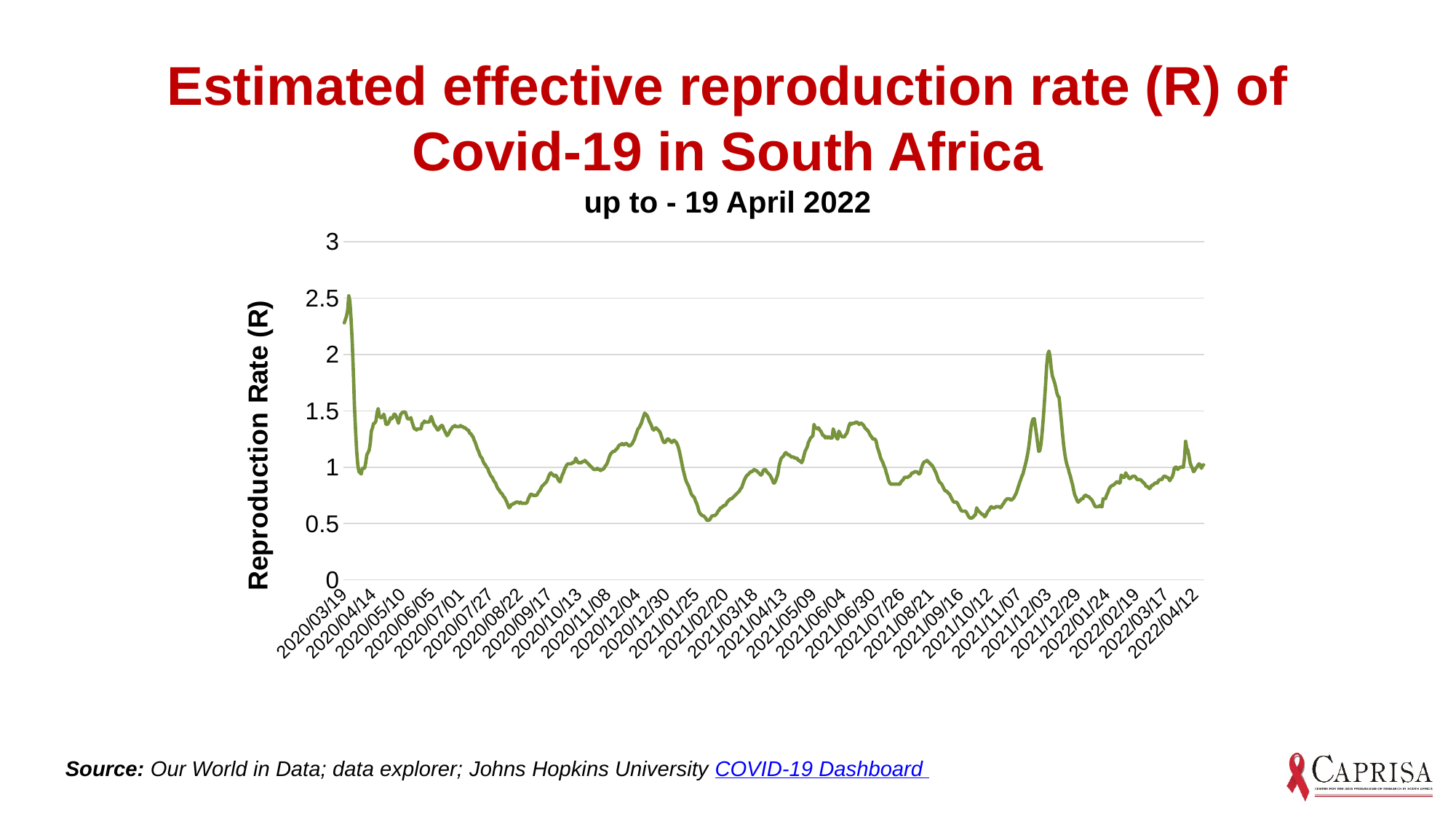
What is the title of the chart on the slide? Estimated effective reproduction rate (R) of Covid-19 in South Africa Is the peak value near 2021/12/03 greater or less than 1.5? greater Is the value at 2020/12/04 greater or less than 1? greater Is the value at 2020/08/22 greater or less than 1? less Between 2021/10/12 and 2021/12/03, does the line rise or fall? rise What kind of chart is shown on the slide? line chart Near which x-axis label does the line reach its highest value? 2020/03/19 Between 2020/03/19 and 2020/04/14, does the line rise or fall? fall What is the label of the vertical axis? Reproduction Rate (R)